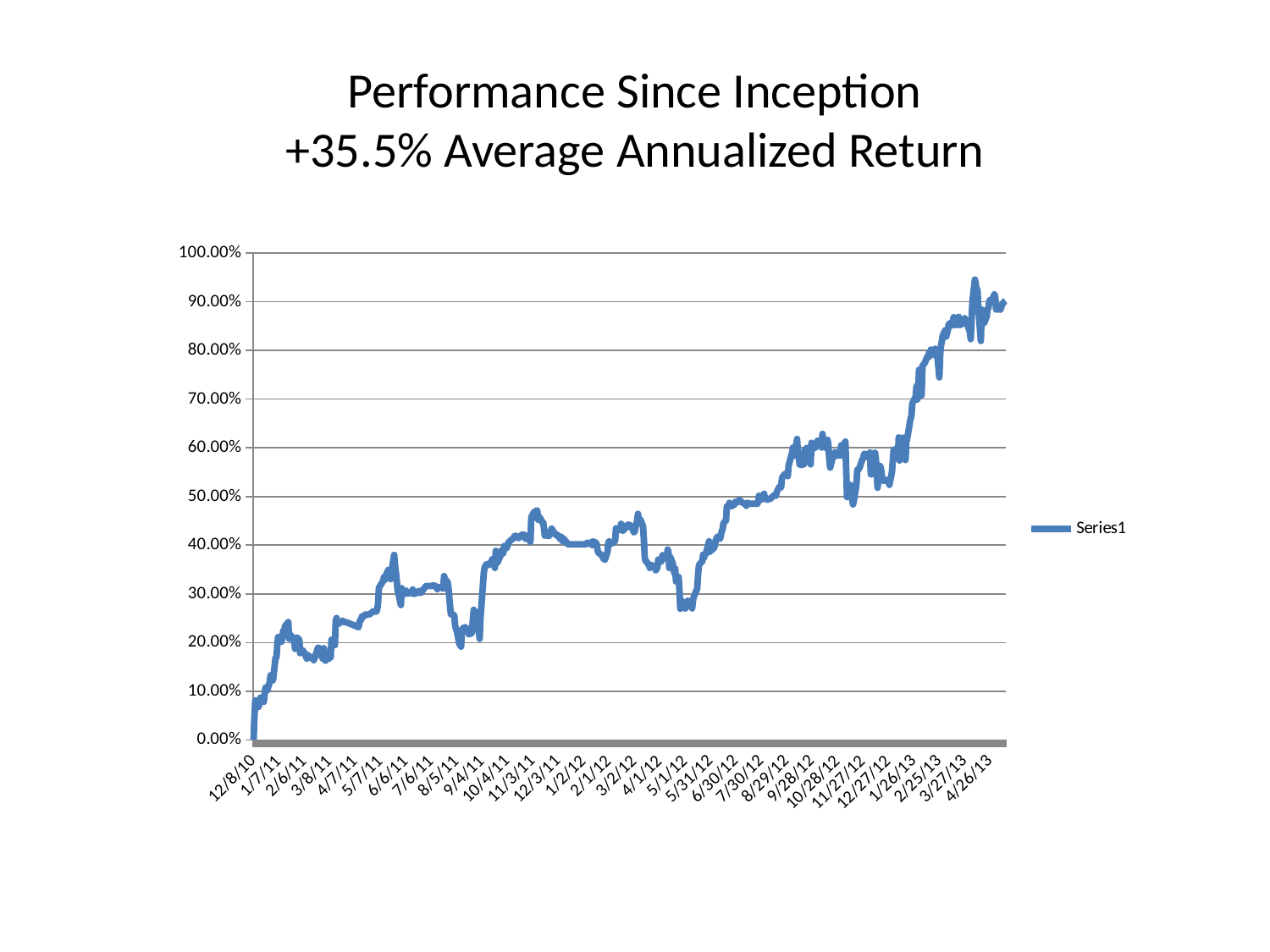
Which is larger, the value at 4/26/13 or the value at 12/8/10? 4/26/13 Overall, do the values rise or fall from 12/8/10 to 4/26/13? rise What kind of chart is shown on the slide? line chart Is the value at 12/8/10 greater or less than 10.00%? less Is the value at 2/6/11 greater or less than 10.00%? greater Is the value at 3/27/13 greater or less than 80.00%? greater What is the name of the series shown in the legend? Series1 What is the title of the chart? Performance Since Inception +35.5% Average Annualized Return How many series does the legend list? 1